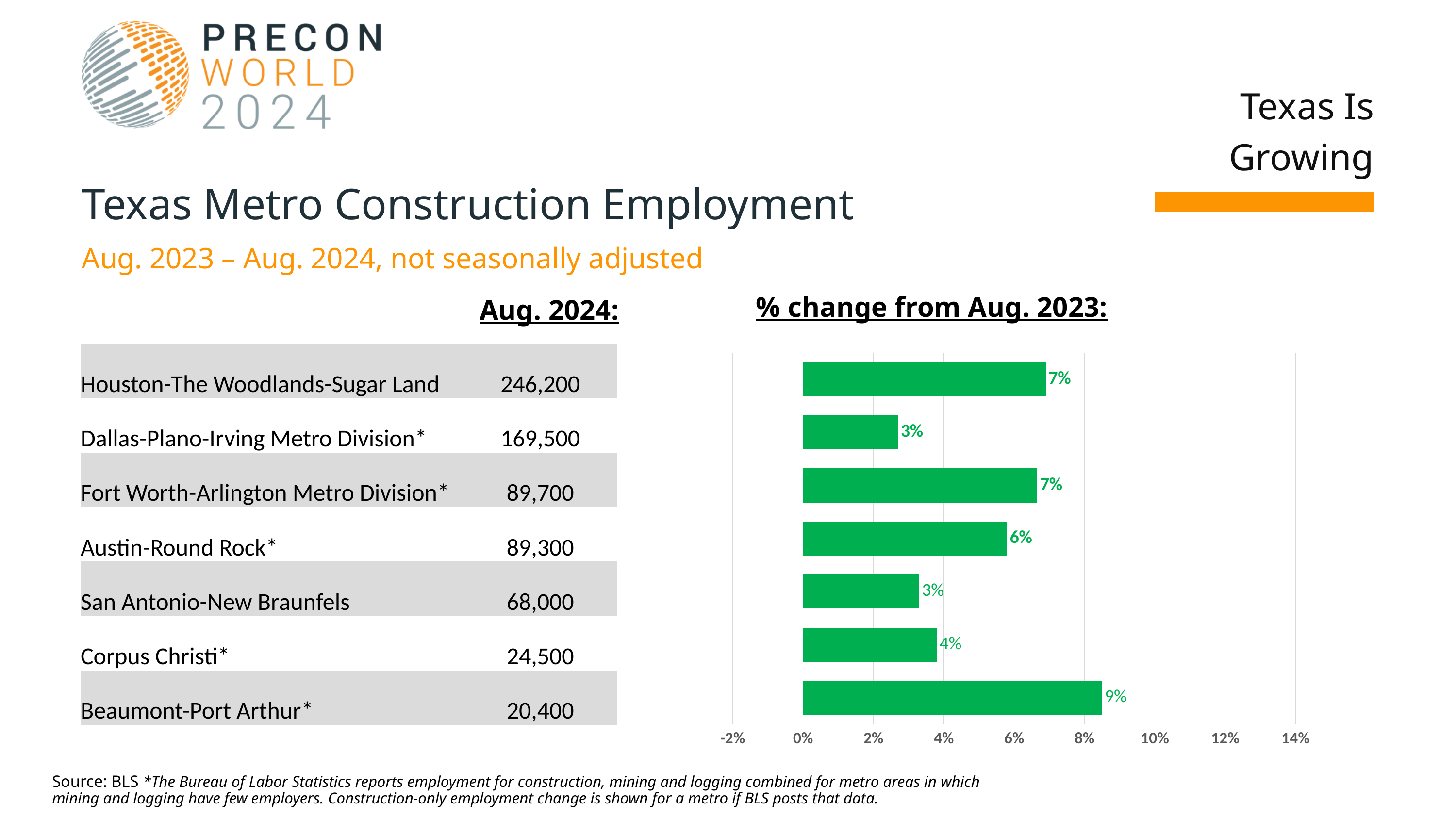
Which has a larger % change from Aug. 2023: Houston-The Woodlands-Sugar Land or Dallas-Plano-Irving Metro Division? Houston-The Woodlands-Sugar Land Which metro area has the highest % change from Aug. 2023 in the chart? Beaumont-Port Arthur Is the % change for Beaumont-Port Arthur greater or less than 8%? greater What is the % change from Aug. 2023 shown for Corpus Christi? 4% How many metro areas are plotted as bars in the chart? 7 What is the % change from Aug. 2023 shown for Beaumont-Port Arthur? 9% Which has a larger % change from Aug. 2023: Austin-Round Rock or Corpus Christi? Austin-Round Rock What colour are the bars in the % change chart? green What is the % change from Aug. 2023 shown for Dallas-Plano-Irving Metro Division? 3% What kind of chart is used to show the % change from Aug. 2023? bar chart What is the % change from Aug. 2023 shown for Austin-Round Rock? 6% What is the difference between the % change for Beaumont-Port Arthur and the % change for San Antonio-New Braunfels? 6%